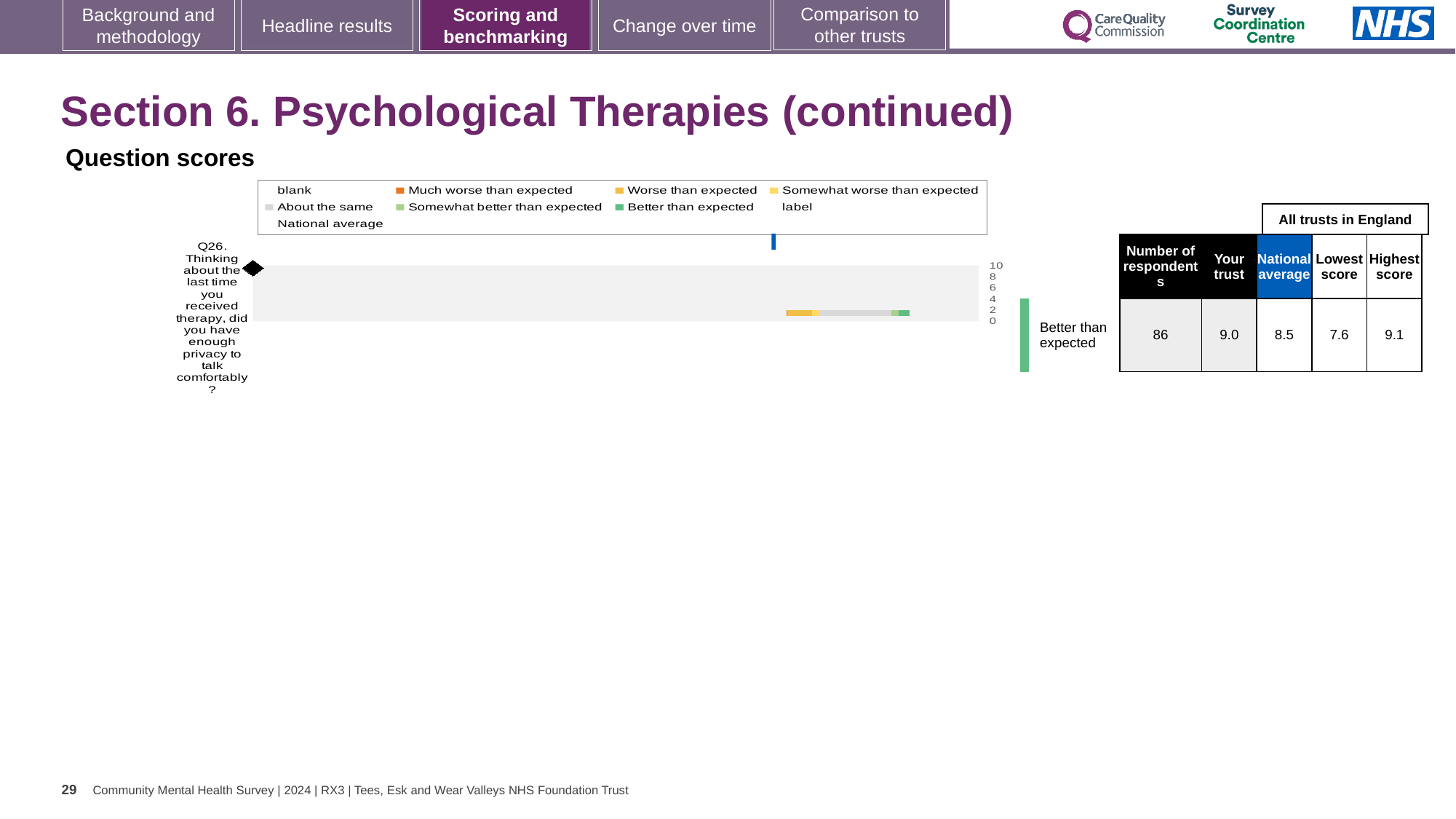
According to the table beside the chart, how many respondents answered Q26? 86 Is the 'Your trust' score for Q26 greater or less than 8? greater Which is larger for Q26, the 'Your trust' score or the national average? Your trust Which question number is plotted on the chart? Q26 What is the highest tick value shown on the chart's axis? 10 According to the table beside the chart, what is the national average for Q26? 8.5 What kind of chart is shown under 'Question scores'? bar chart How many questions (categories) are plotted on the chart? 1 Which benchmark category is the trust's Q26 score labelled as on the chart? Better than expected According to the table beside the chart, what is the 'Your trust' score for Q26? 9.0 What is the difference between the highest score (9.1) and the lowest score (7.6) for Q26 across all trusts in England? 1.5 How many entries does the chart legend list? 9